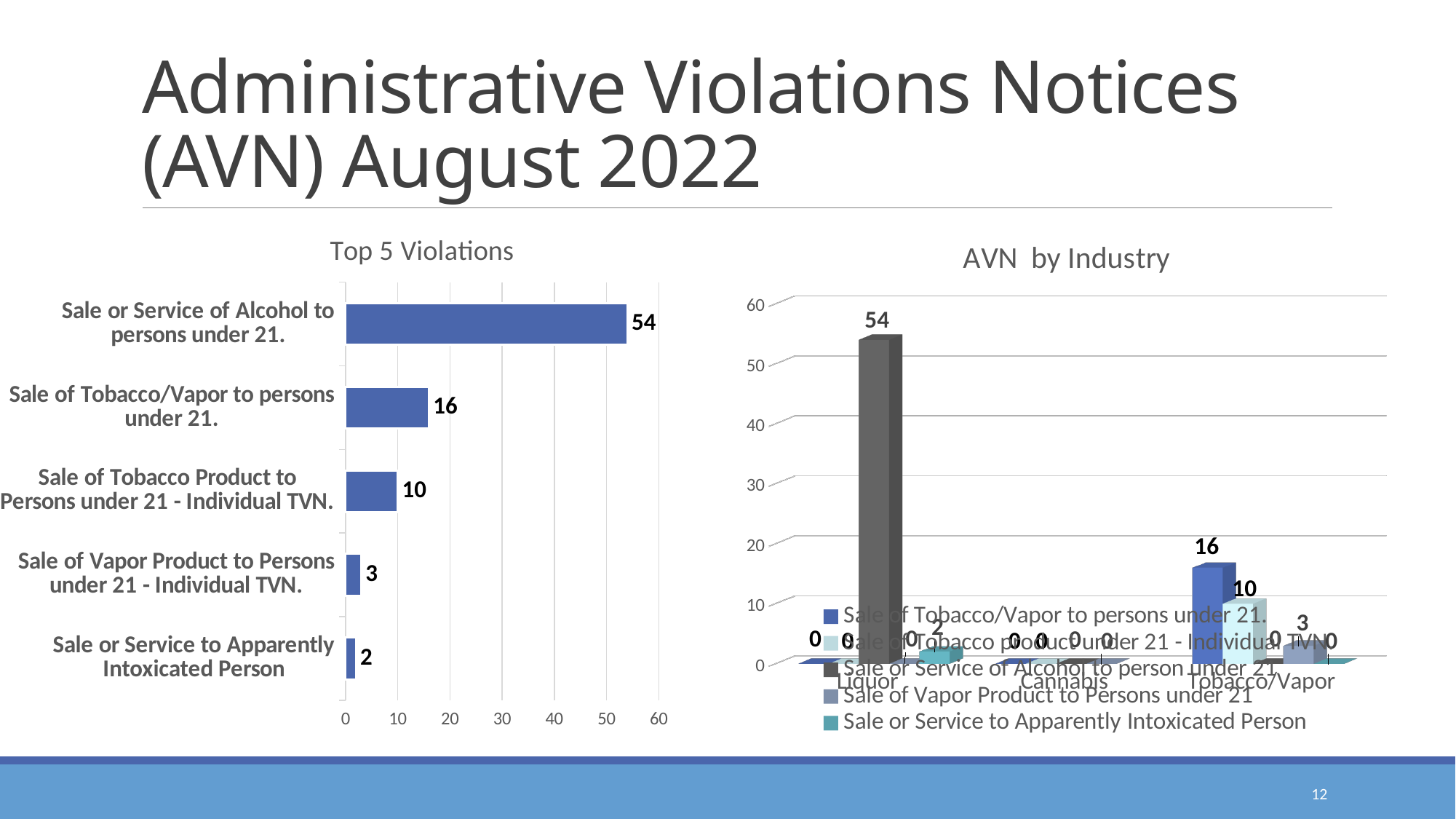
In the AVN by Industry chart, what is the value for Sale of Tobacco/Vapor to persons under 21 in the Tobacco/Vapor industry? 16 In the Top 5 Violations chart, which violation has the highest value? Sale or Service of Alcohol to persons under 21. In the Top 5 Violations chart, what is the value for Sale of Tobacco/Vapor to persons under 21? 16 In the Top 5 Violations chart, which violation has the lowest value? Sale or Service to Apparently Intoxicated Person In the Top 5 Violations chart, how many violation categories are shown? 5 In the AVN by Industry chart, which is larger: Sale of Tobacco/Vapor to persons under 21 or Sale of Vapor Product to Persons under 21 in the Tobacco/Vapor industry? Sale of Tobacco/Vapor to persons under 21 In the Top 5 Violations chart, what is the value for Sale or Service to Apparently Intoxicated Person? 2 In the Top 5 Violations chart, what is the difference between Sale of Tobacco/Vapor to persons under 21 and Sale of Tobacco Product to Persons under 21 - Individual TVN? 6 What kind of chart is the Top 5 Violations chart? Bar chart In the AVN by Industry chart, how many series does the legend list? 5 In the AVN by Industry chart, what is the value for Sale or Service of Alcohol to person under 21 in the Liquor industry? 54 In the Top 5 Violations chart, what is the value for Sale or Service of Alcohol to persons under 21? 54